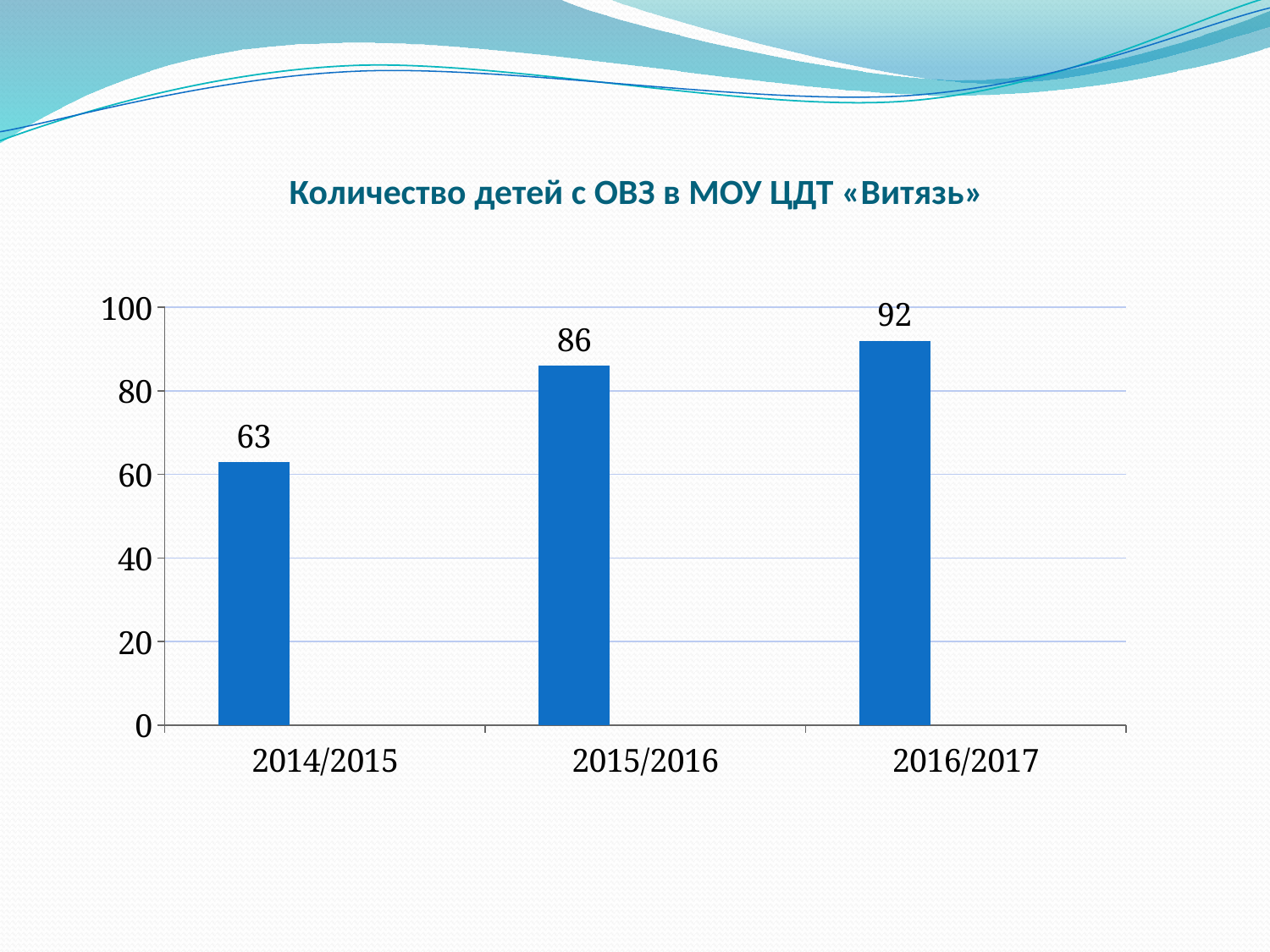
What is the value for 2016/2017? 92 Which year has the highest value? 2016/2017 What is the value for 2015/2016? 86 Which is larger, the value for 2015/2016 or the value for 2016/2017? 2016/2017 Do the values rise or fall from 2014/2015 to 2016/2017? rise How many years are shown on the x axis? 3 What is the difference between the values for 2016/2017 and 2014/2015? 29 Is the value for 2014/2015 greater or less than 80? less What kind of chart is shown on the slide? bar chart What is the difference between the values for 2015/2016 and 2014/2015? 23 What is the value for 2014/2015? 63 Which year has the lowest value? 2014/2015